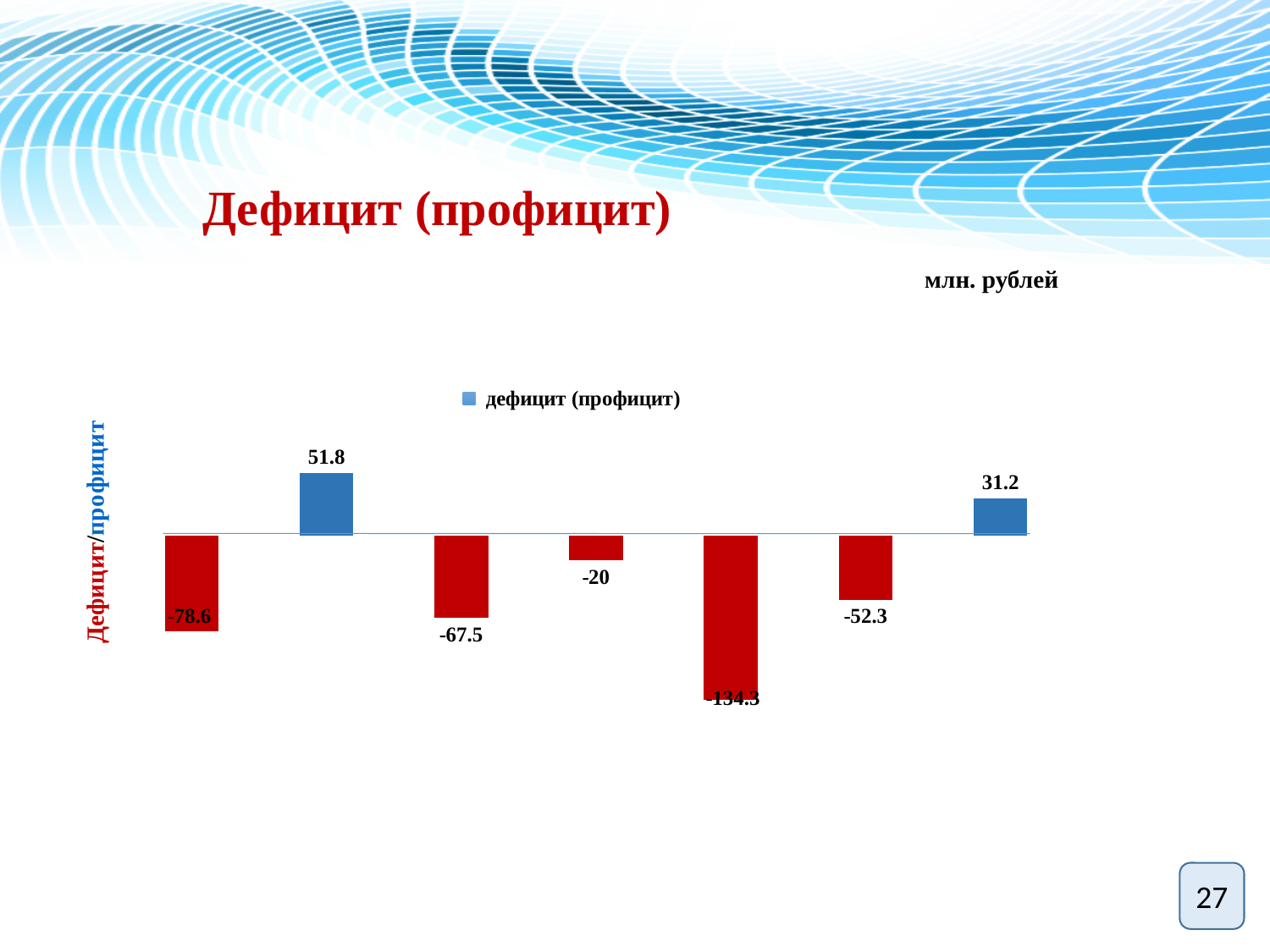
How many series does the legend list? 1 What is the value of the last (rightmost) bar? 31.2 What is the value of the second bar from the left? 51.8 Which bar has the lowest value? the fifth bar (-134.3) What is the value of the first (leftmost) bar? -78.6 How many bars are plotted in the chart? 7 What unit is stated for the values in the chart? млн. рублей What type of chart is shown on the slide? bar chart Which is larger, the value of the fourth bar or the value of the sixth bar? the fourth bar (-20) What is the value of the fifth bar from the left? -134.3 Which bar has the highest value? the second bar (51.8) What is the difference between the second bar (51.8) and the last bar (31.2)? 20.6